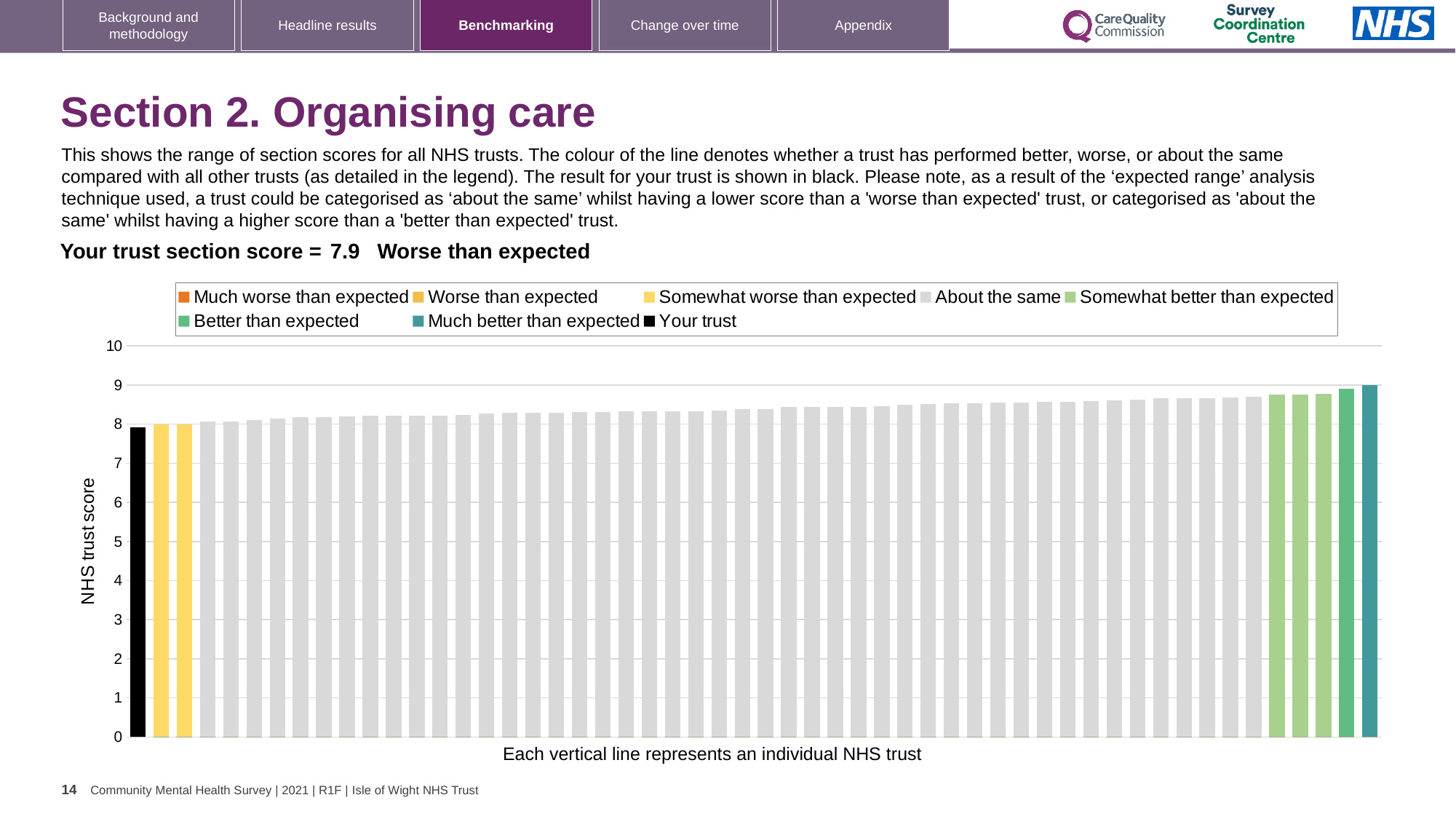
How many entries does the chart legend list? 8 Do the bar values rise or fall from left to right along the x axis? rise What kind of chart is shown on the slide? bar chart What is the label on the vertical axis of the chart? NHS trust score Which performance category is your trust's section score labelled with on the slide? Worse than expected Is the value for your trust greater or less than 8? less What is the section score for your trust shown on the slide? 7.9 Which is larger: the bar for your trust or the rightmost bar in the chart? the rightmost bar Is the value of the tallest bar in the chart greater or less than 8? greater What colour is the bar representing your trust? black Which legend category does the tallest bar in the chart belong to? Much better than expected Is the value of the shortest bar in the chart greater or less than 7? greater